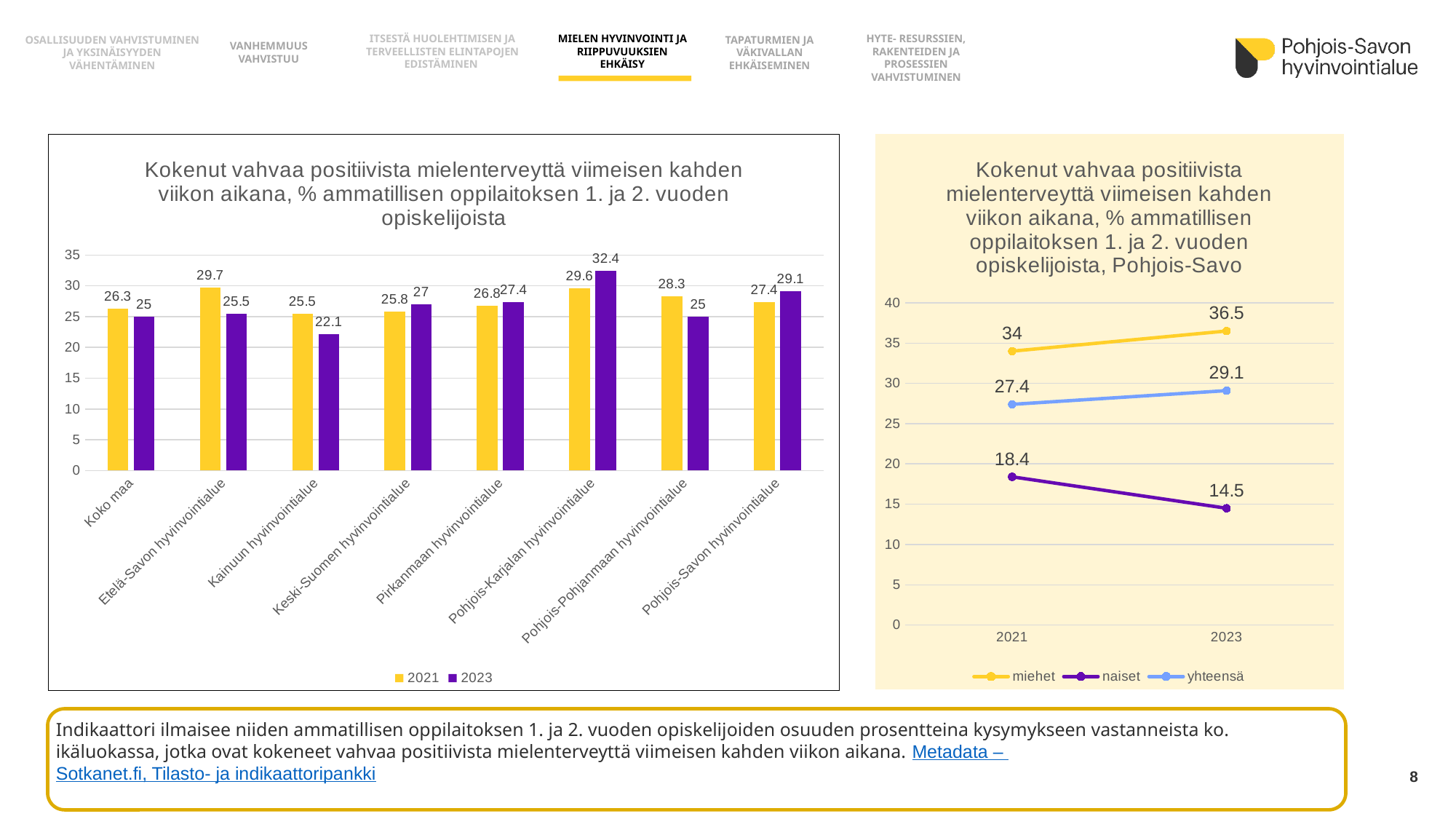
In the left bar chart, what is the difference between the 2021 and 2023 values for Etelä-Savon hyvinvointialue? 4.2 In the left bar chart, what is the 2023 value for Pohjois-Karjalan hyvinvointialue? 32.4 How many series does the legend of the right line chart list? 3 In the left bar chart, which region has the highest 2023 value? Pohjois-Karjalan hyvinvointialue In the left bar chart, is the 2021 value for Koko maa larger or smaller than its 2023 value? larger What type of chart is the chart on the left of the slide? bar chart How many regions (categories) are shown in the left bar chart? 8 In the left bar chart, what is the 2021 value for Kainuun hyvinvointialue? 25.5 In the right line chart (Pohjois-Savo), what is the value for naiset in 2023? 14.5 In the right line chart (Pohjois-Savo), does the value for naiset rise or fall from 2021 to 2023? fall In the left bar chart, which region has the lowest 2023 value? Kainuun hyvinvointialue In the right line chart (Pohjois-Savo), what is the difference between the miehet values in 2023 and 2021? 2.5